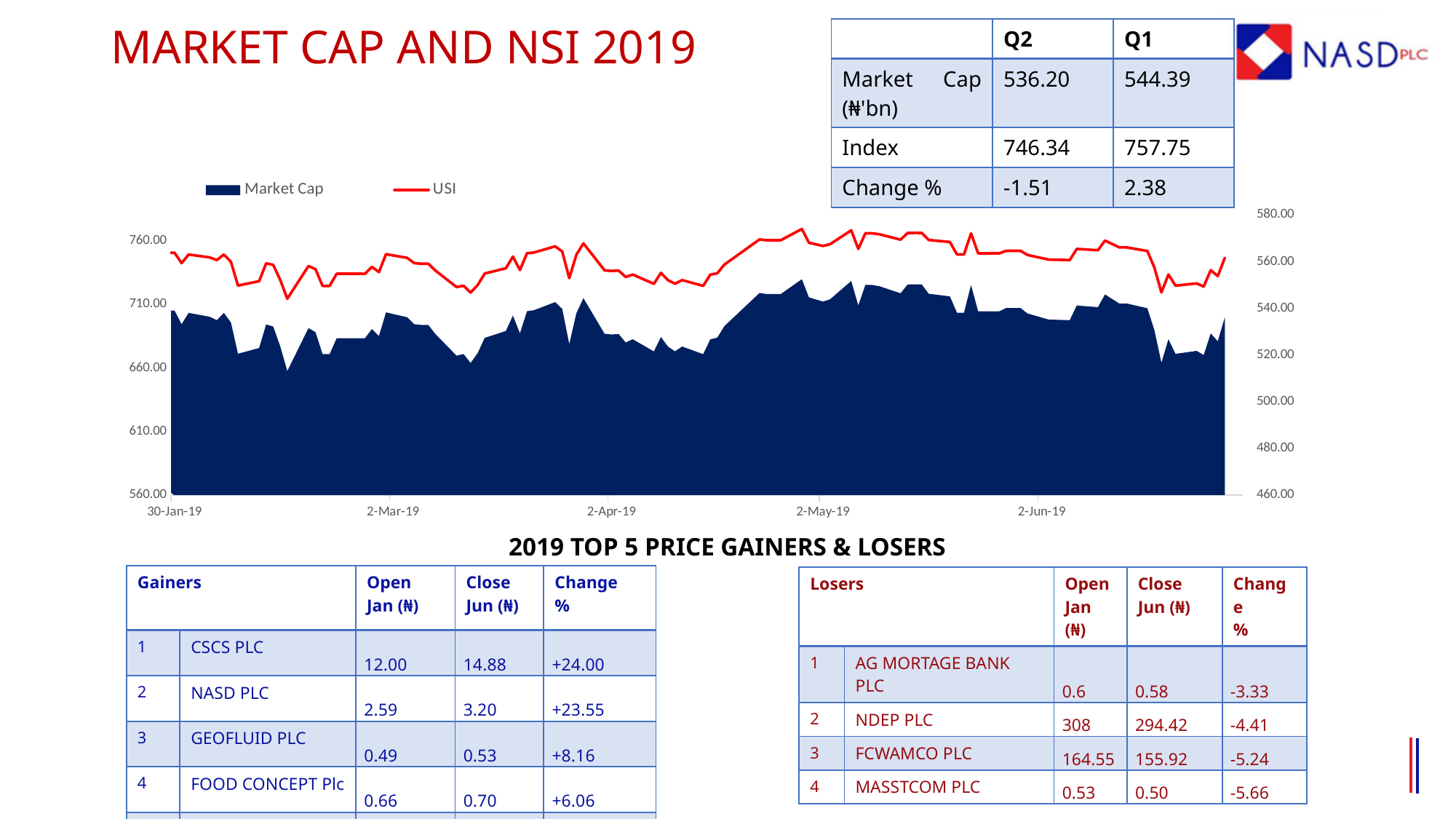
Is the Market Cap value around 2-Jun-19 greater or less than 560.00 on the right axis? less Is the Market Cap value at 30-Jan-19 greater or less than 520.00 on the right axis? greater What kind of chart is shown on the slide? Area chart with a line series Is the USI value around 2-May-19 greater or less than 710.00? greater How many series does the chart legend list? 2 Which series is drawn as a red line in the chart? USI How many date labels are shown on the x axis of the chart? 5 Which series is shown as the dark blue filled area in the chart? Market Cap